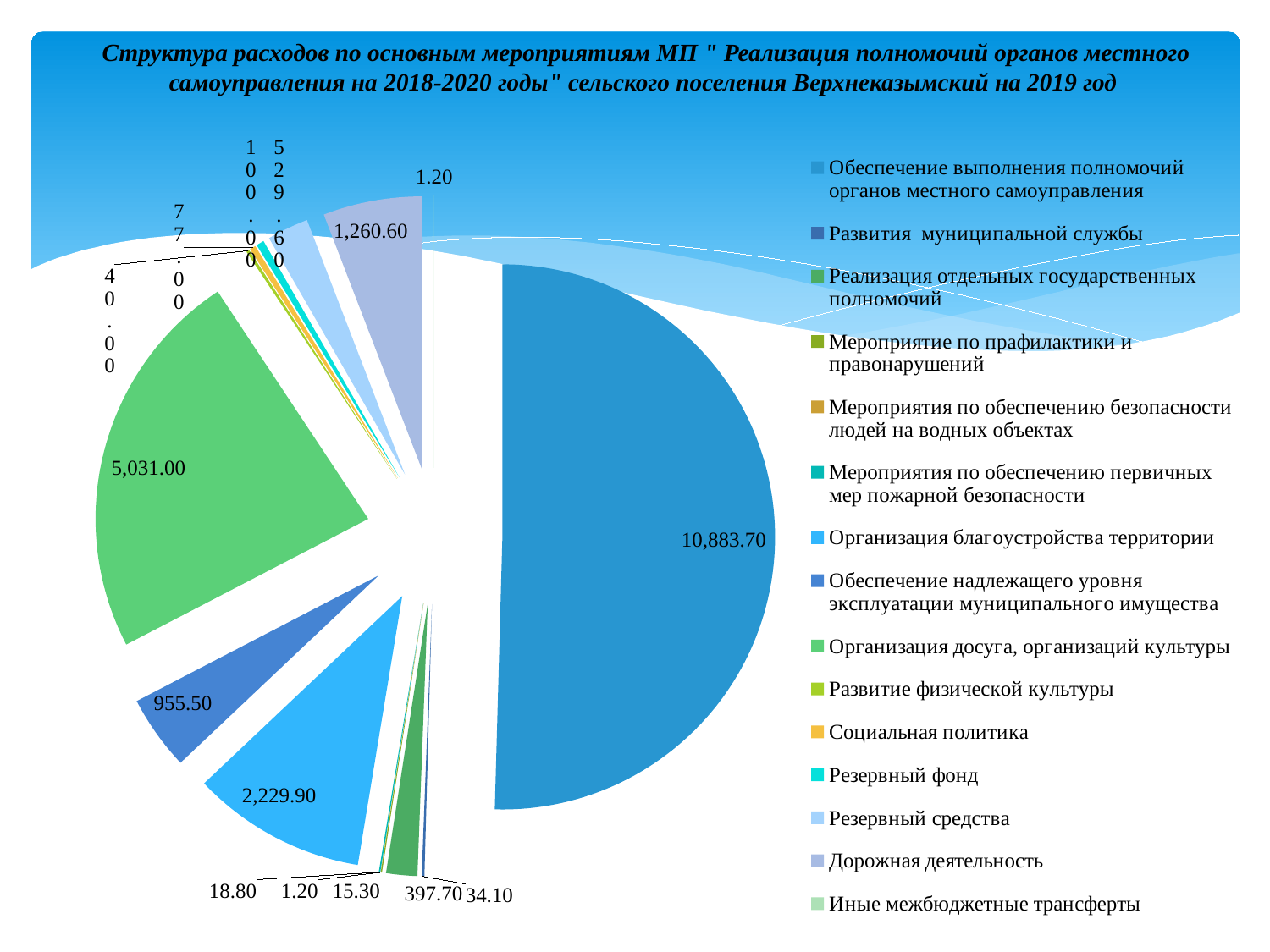
What kind of chart is shown on the slide? pie chart How many categories does the legend of the pie chart list? 15 What is the difference between the largest slice (10,883.70) and the slice labelled 5,031.00? 5,852.70 What is the value shown for the green slice 'Организация досуга, организаций культуры'? 5,031.00 What is the value of the largest slice of the pie chart? 10,883.70 What is the value shown for 'Обеспечение надлежащего уровня эксплуатации муниципального имущества'? 955.50 What is the value shown for 'Дорожная деятельность'? 1,260.60 What year does the chart title say the expenditure structure refers to? 2019 What is the difference between the slices labelled 2,229.90 and 955.50? 1,274.40 What is the value shown for 'Организация благоустройства территории'? 2,229.90 Which is larger: the slice for 'Организация благоустройства территории' or the slice for 'Обеспечение надлежащего уровня эксплуатации муниципального имущества'? Организация благоустройства территории Which category has the largest slice in the pie chart? Обеспечение выполнения полномочий органов местного самоуправления